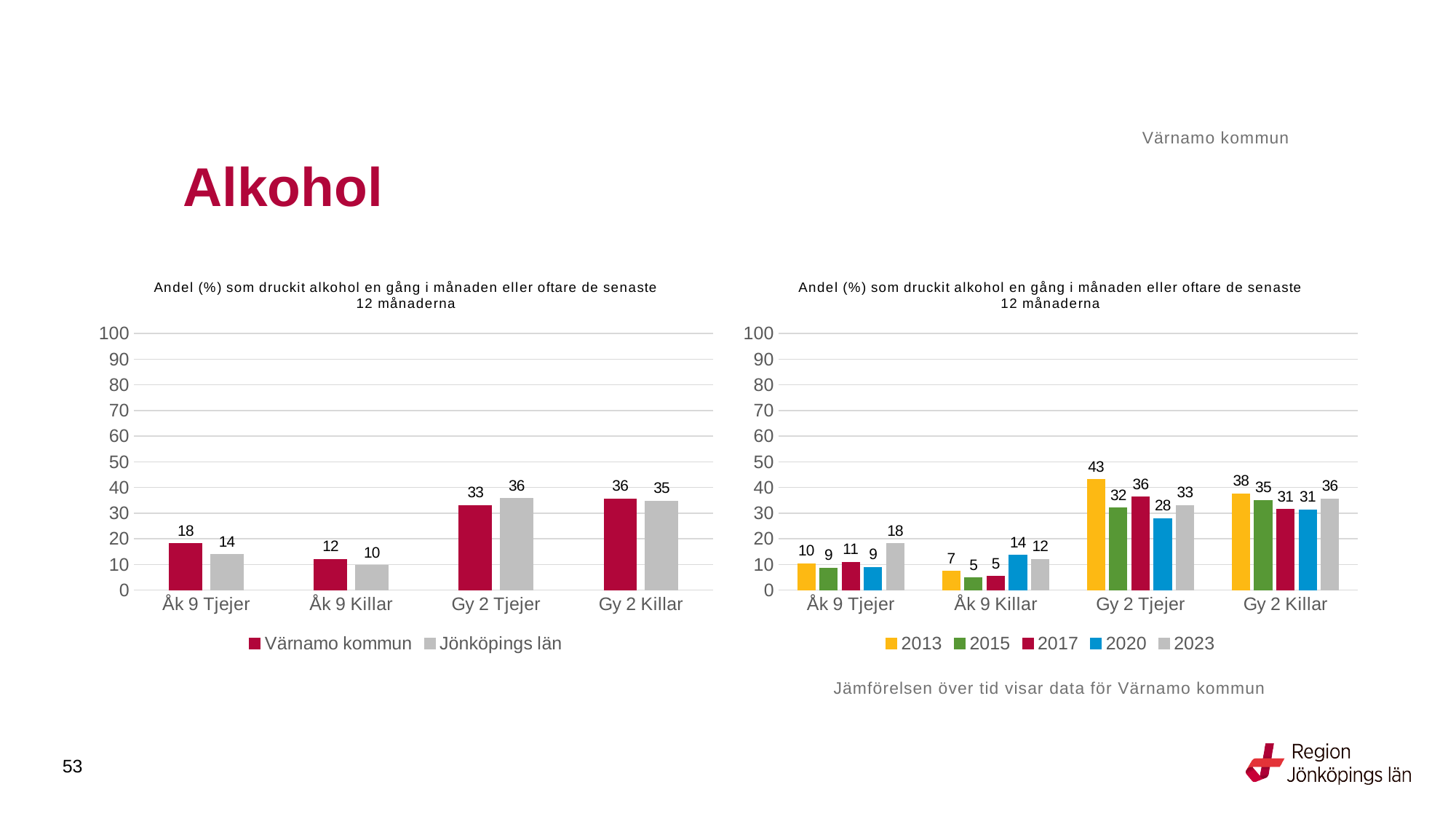
In the right chart, which is larger for Åk 9 Tjejer: the value for 2020 or the value for 2023? 2023 What kind of chart is the left chart? Bar chart In the left chart, how many series does the legend list? 2 In the right chart, how many series does the legend list? 5 In the right chart, what is the difference between the 2013 and 2020 values for Gy 2 Tjejer? 15 In the left chart, what is the value for Värnamo kommun for Åk 9 Tjejer? 18 In the left chart, what is the difference between Värnamo kommun and Jönköpings län for Åk 9 Tjejer? 4 In the left chart, which category has the lowest value for Jönköpings län? Åk 9 Killar In the right chart, what is the value for 2023 for Åk 9 Killar? 12 In the right chart, which year has the highest value for Gy 2 Killar? 2013 In the right chart, what is the value for 2013 for Gy 2 Tjejer? 43 In the left chart, what is the value for Jönköpings län for Gy 2 Tjejer? 36